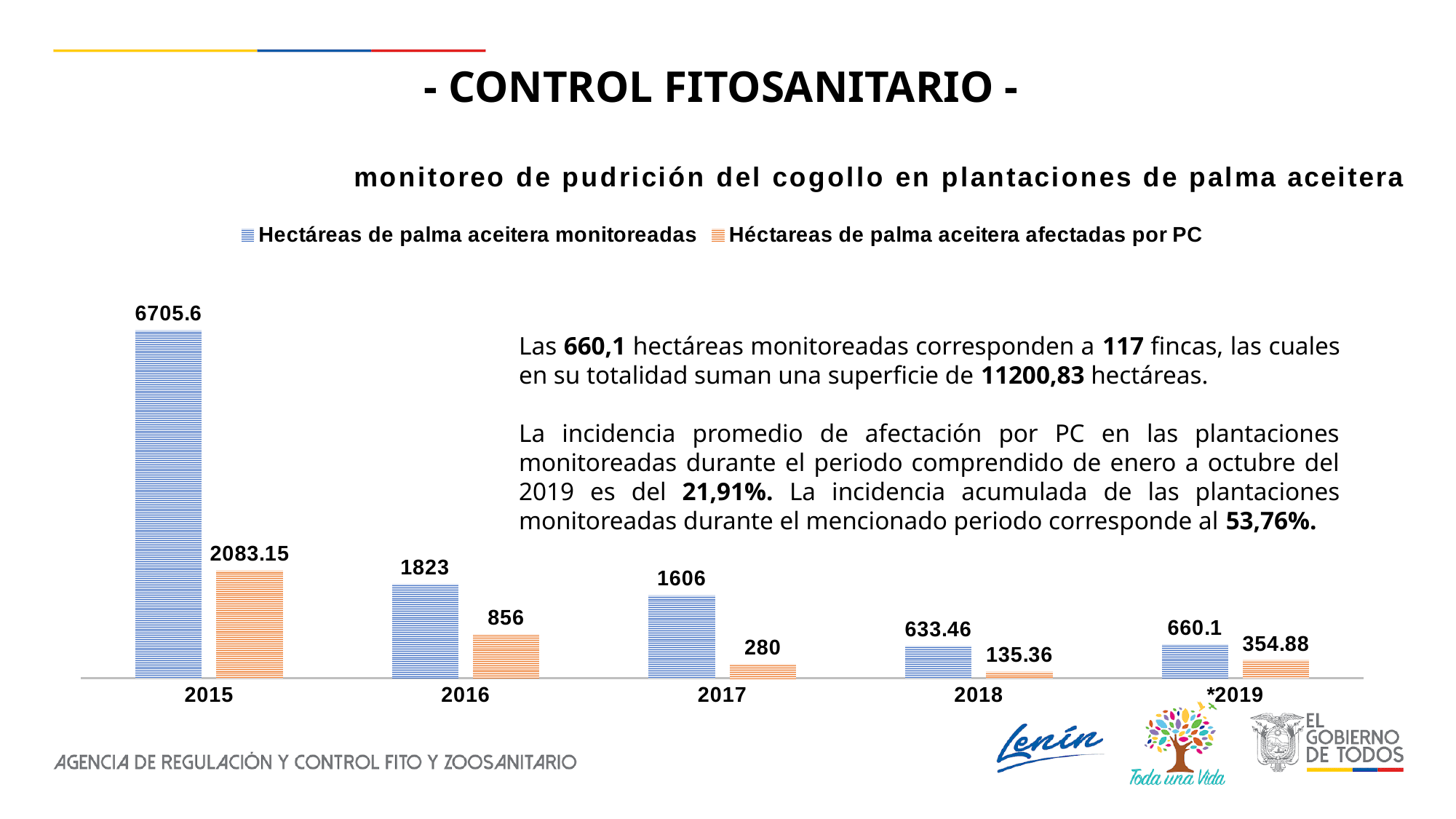
How many series does the legend list? 2 What is the value of Hectáreas de palma aceitera monitoreadas for 2018? 633.46 What is the difference between Hectáreas de palma aceitera monitoreadas and Héctareas de palma aceitera afectadas por PC in 2016? 967 Which year has the lowest value of Héctareas de palma aceitera afectadas por PC? 2018 What is the value of Héctareas de palma aceitera afectadas por PC for 2016? 856 Do the values of Hectáreas de palma aceitera monitoreadas rise or fall from 2015 to 2018? fall What is the value of Héctareas de palma aceitera afectadas por PC for *2019? 354.88 What is the value of Hectáreas de palma aceitera monitoreadas for 2015? 6705.6 What kind of chart is shown on the slide? bar chart Which year has the highest value of Hectáreas de palma aceitera monitoreadas? 2015 How many years are shown on the x axis of the chart? 5 Which is larger: Héctareas de palma aceitera afectadas por PC in 2017 or in *2019? *2019